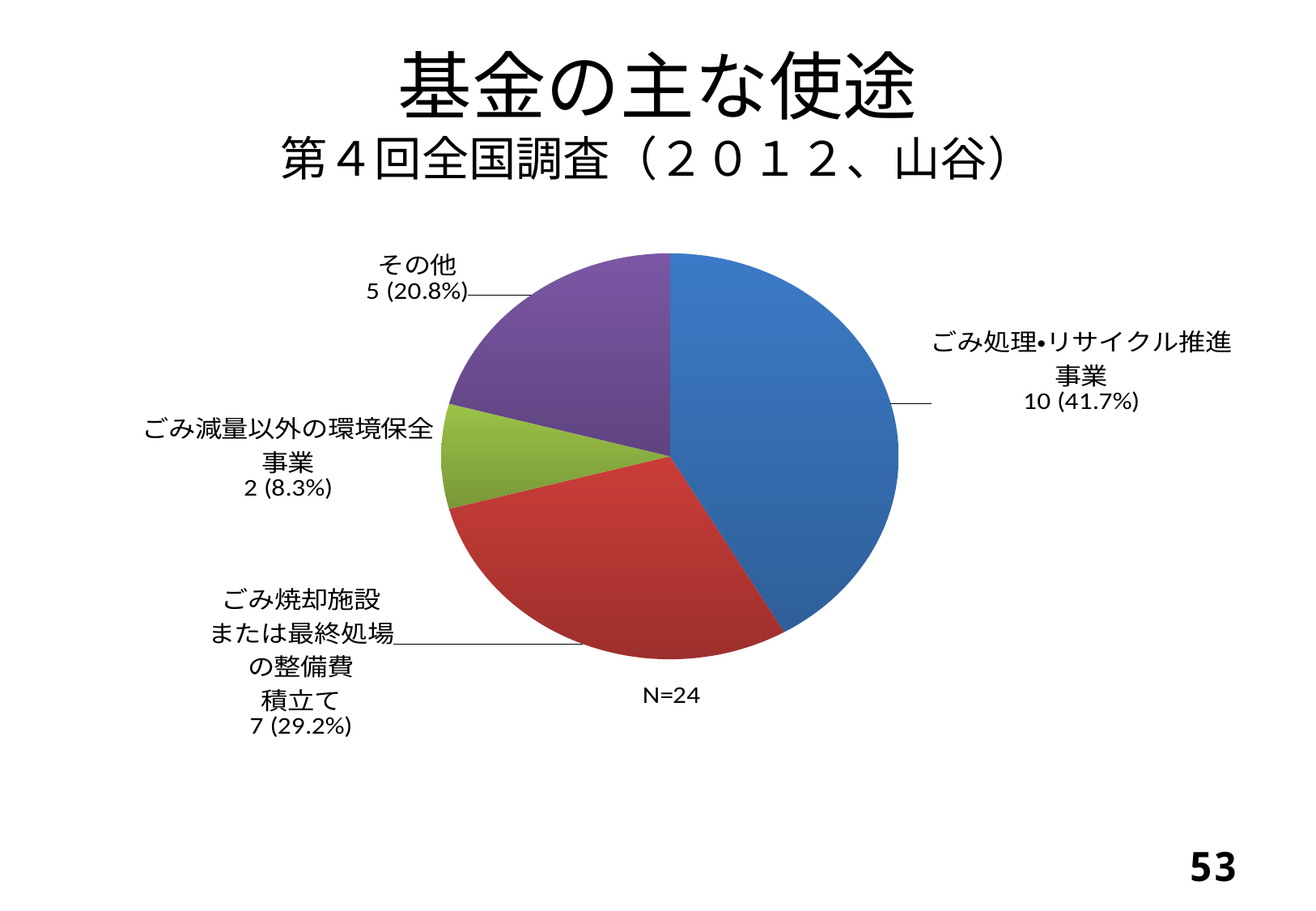
Which category has the largest slice of the pie? ごみ処理•リサイクル推進事業 What is the value shown for その他? 5 (20.8%) What is the value shown for ごみ減量以外の環境保全事業? 2 (8.3%) What kind of chart is shown on the slide? pie chart Which category has the smallest slice of the pie? ごみ減量以外の環境保全事業 Which is larger, ごみ焼却施設または最終処場の整備費積立て or その他? ごみ焼却施設または最終処場の整備費積立て What share of the pie does その他 represent? 20.8% How many slices does the pie chart have? 4 What is the difference in count between ごみ処理•リサイクル推進事業 and その他? 5 What is the total N shown for the pie chart? N=24 What is the value shown for ごみ処理•リサイクル推進事業? 10 (41.7%) What is the value shown for ごみ焼却施設または最終処場の整備費積立て? 7 (29.2%)